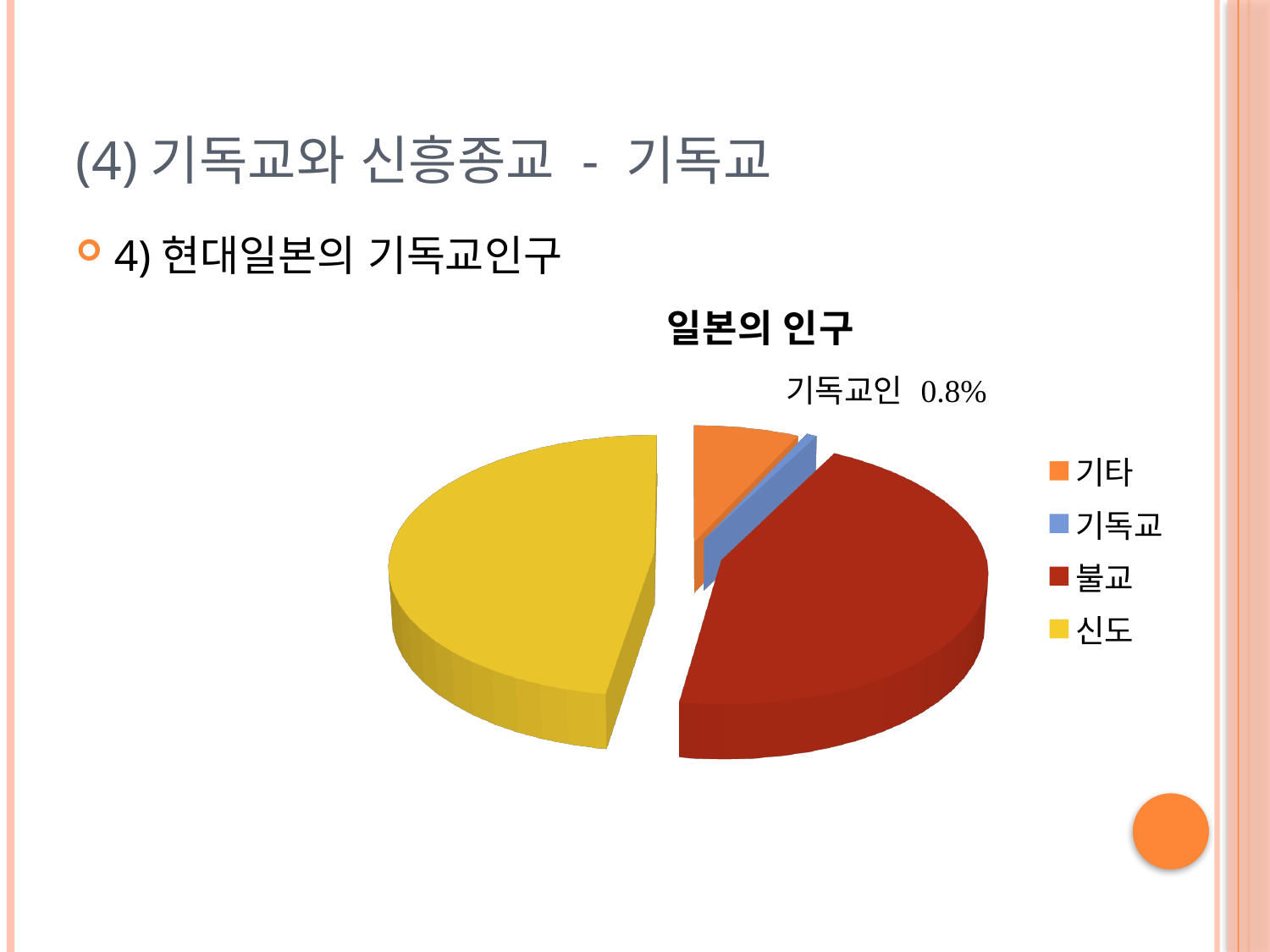
Which slice is larger, 불교 or 기타? 불교 Which category has the smallest slice of the pie? 기독교 What share of the pie is labelled for 기독교인? 0.8% Which slice is larger, 신도 or 기독교? 신도 Which slice is larger, 기타 or 기독교? 기타 How many entries does the legend list? 4 What colour is the 불교 slice in the pie chart? red What kind of chart is shown on the slide? pie chart How many categories does the pie chart have? 4 What is the title of the chart? 일본의 인구